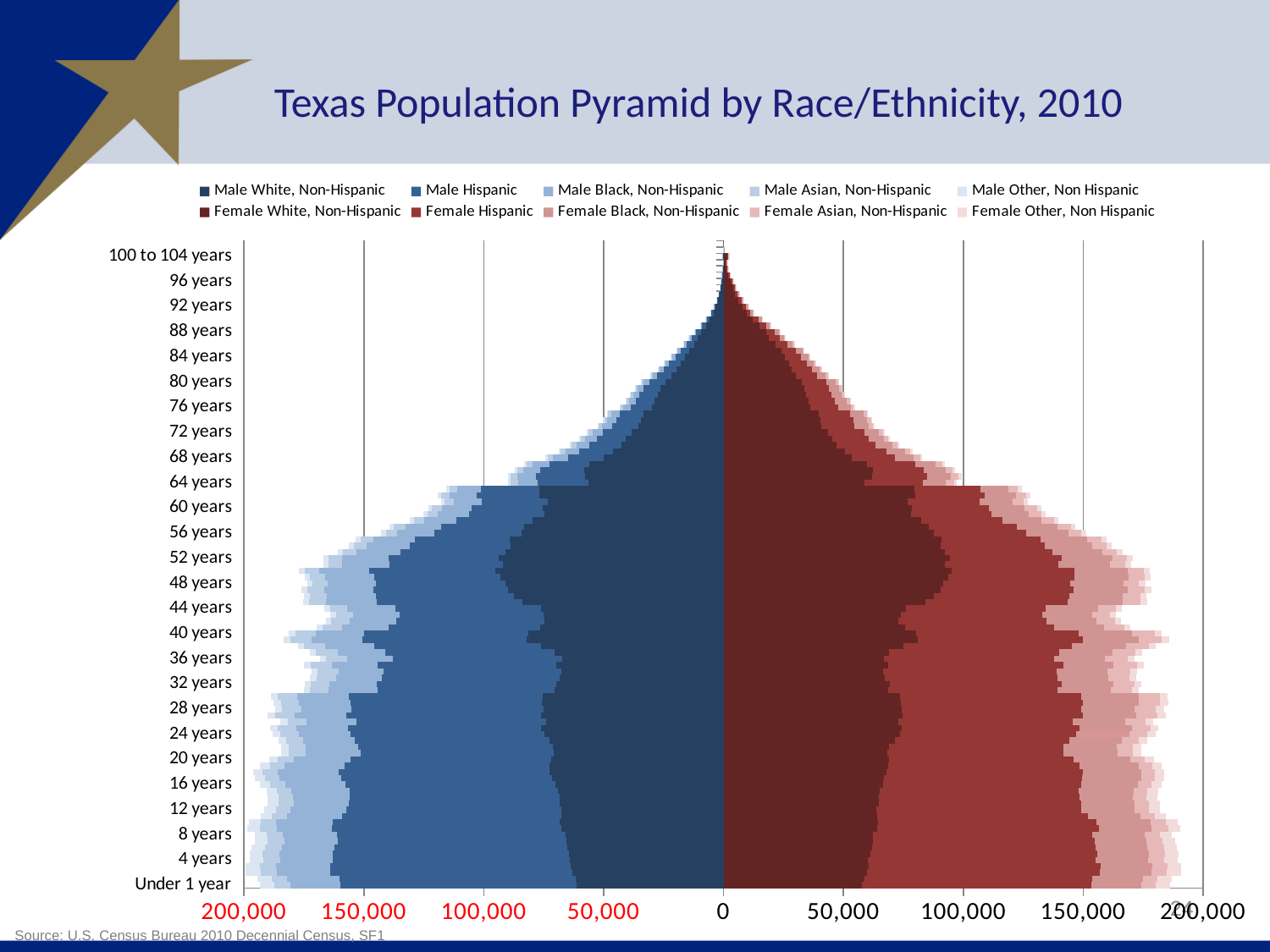
Is the total male population at 40 years greater or less than 150,000? greater Is the total male population at 64 years greater or less than 100,000? less Is the total male population at 80 years greater or less than 50,000? less At 80 years, which is larger, the total male population or the total female population? female Which side of the chart shows the male population, left or right? left How many series does the legend list? 10 What kind of chart is shown on the slide? bar chart Do the bar lengths generally increase or decrease as age increases from Under 1 year to 100 to 104 years? decrease What is the title of the chart? Texas Population Pyramid by Race/Ethnicity, 2010 What is the largest value shown on the horizontal axis? 200,000